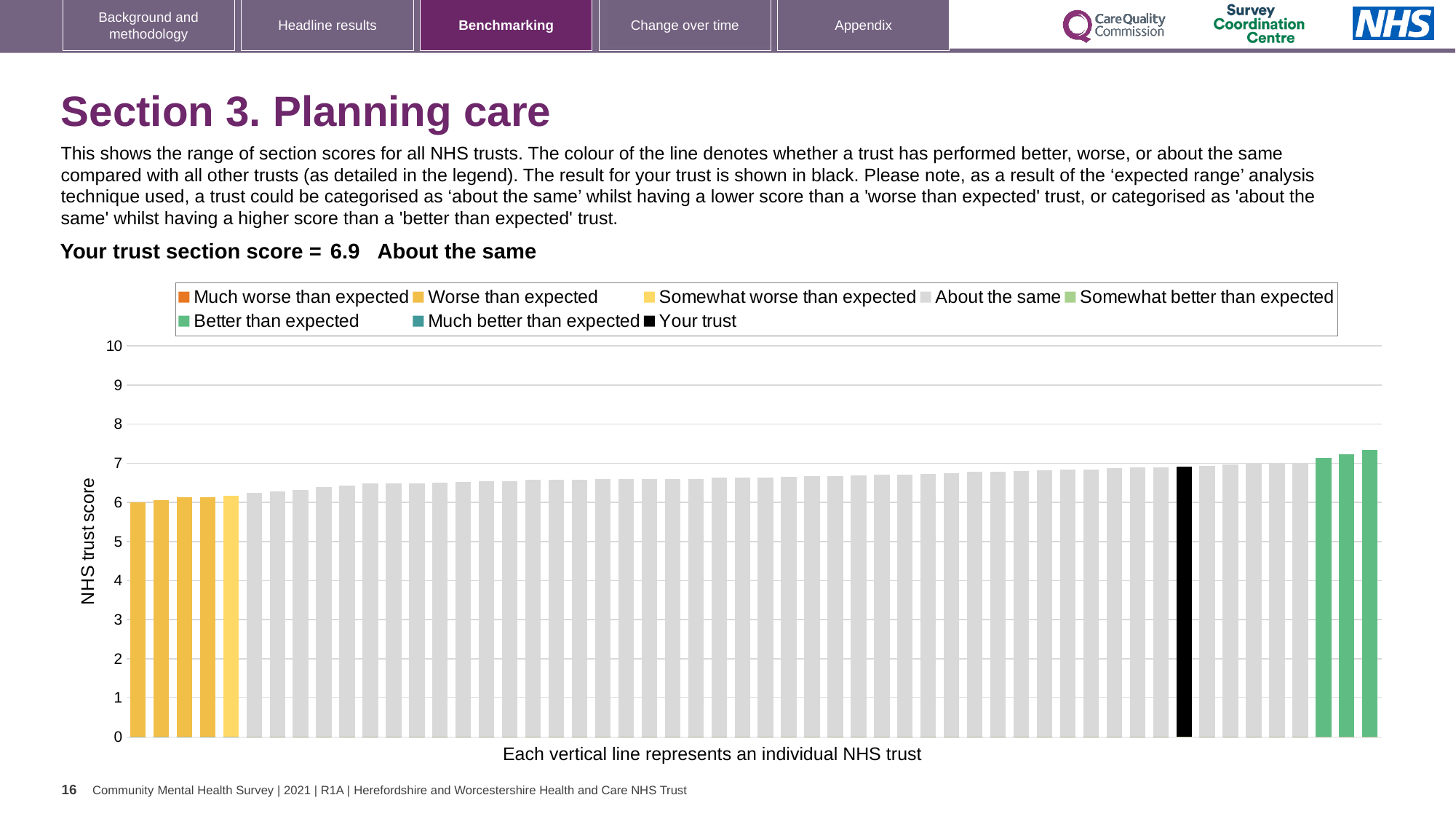
Which legend category does the highest bar belong to? Better than expected Which legend category does your trust fall into? About the same What kind of chart is shown on the slide? bar chart Do the bar values rise or fall from left to right along the x axis? rise What is the section score for your trust shown on the slide? 6.9 What colour is the bar representing your trust? black How many bars are coloured as 'Better than expected'? 3 How many bars are coloured as 'Worse than expected'? 4 Is the value of the lowest bar greater or less than 5? greater What is the label on the y axis of the chart? NHS trust score Is the value of the highest bar greater or less than 8? less How many entries does the chart legend list? 8